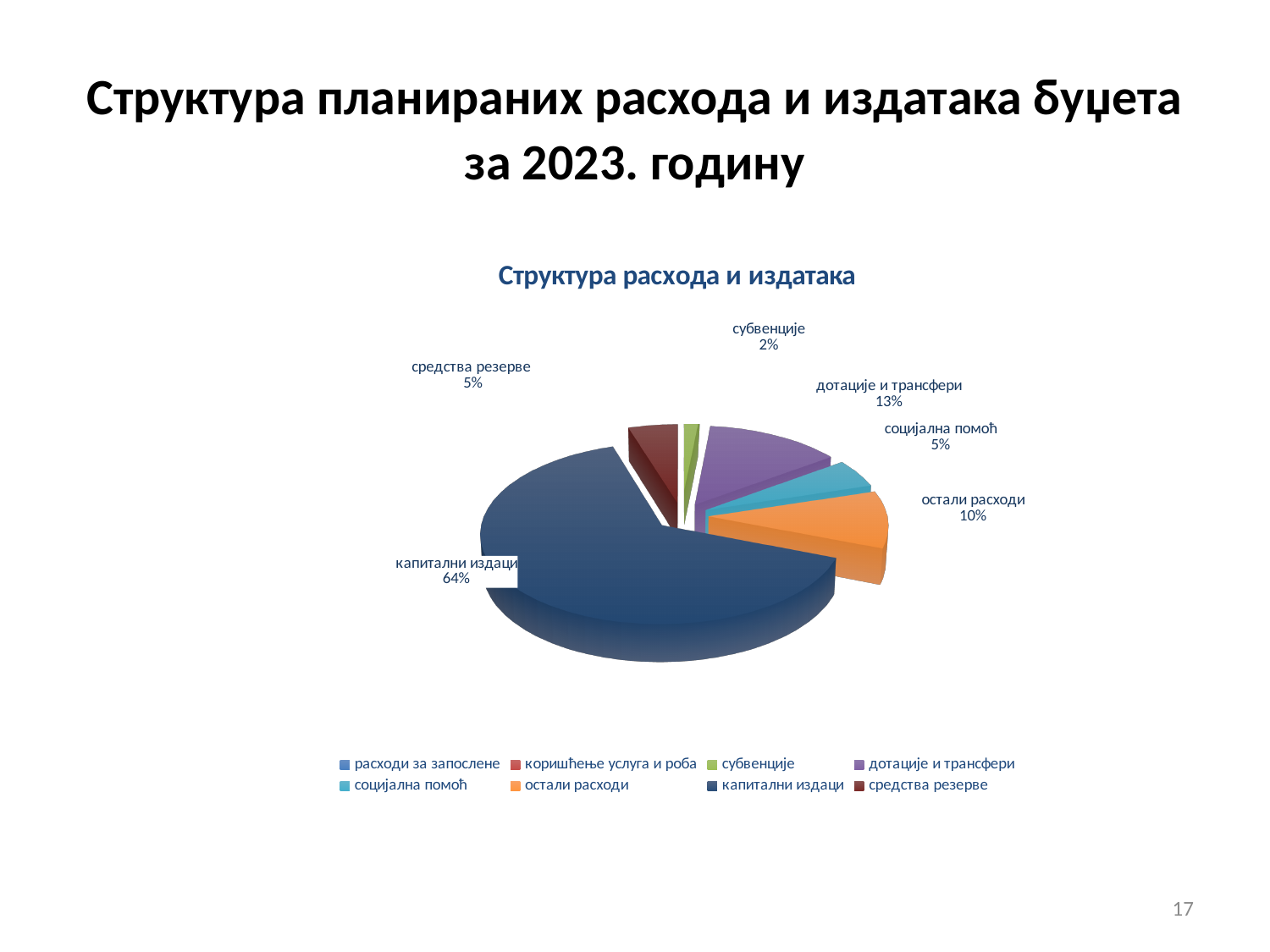
What percentage is shown for субвенције? 2% What is the title of the chart? Структура расхода и издатака How many entries does the legend list? 8 Among the slices with a printed percentage, which is the smallest? субвенције Which is larger, the share for остали расходи or the share for социјална помоћ? остали расходи What percentage is shown for остали расходи? 10% What percentage is shown for средства резерве? 5% What kind of chart is shown on the slide? pie chart What share of the pie does капитални издаци represent? 64% What percentage is shown for дотације и трансфери? 13% What is the difference in percentage points between капитални издаци and дотације и трансфери? 51 Which category has the largest slice of the pie? капитални издаци